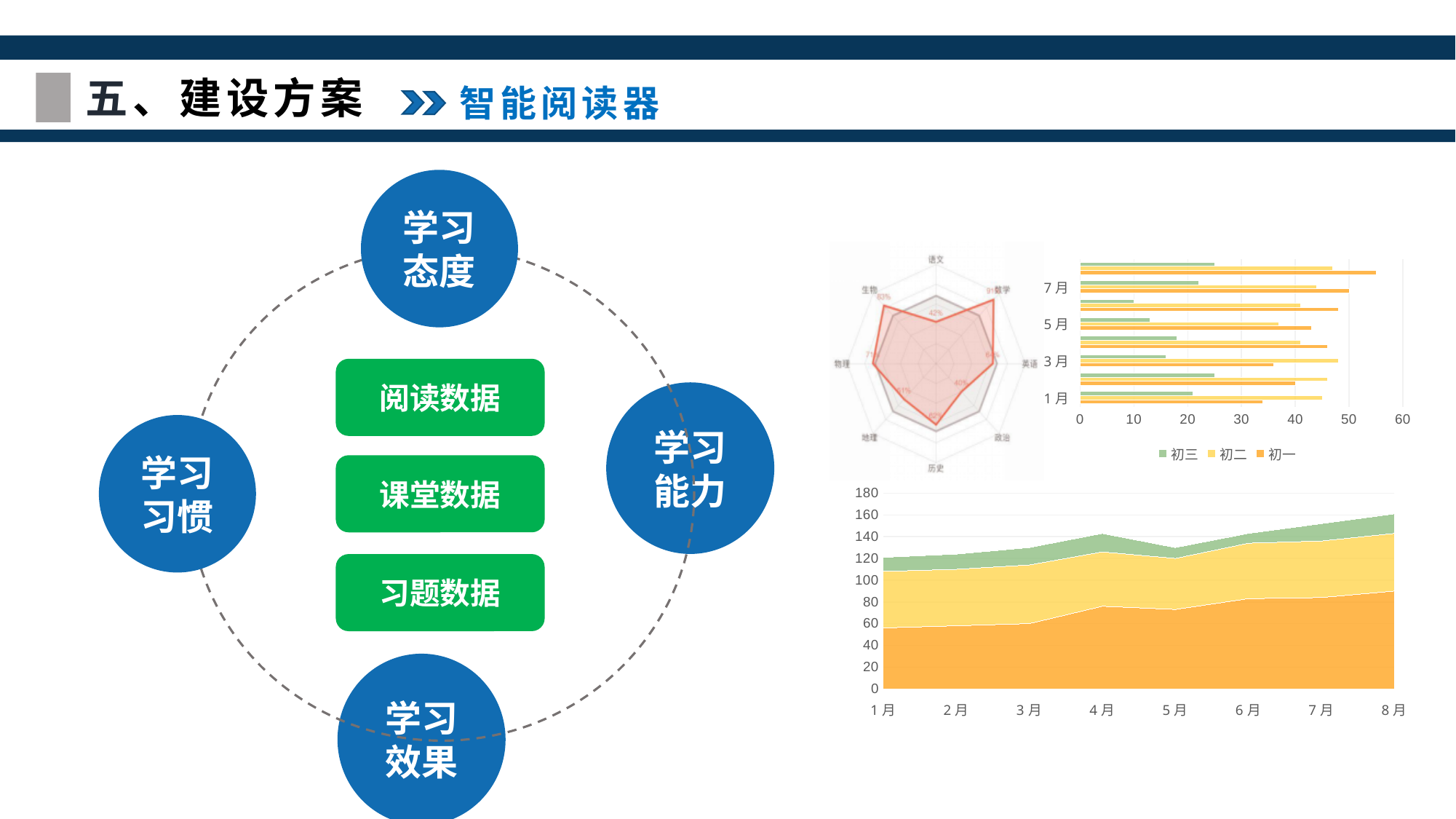
In the top-right bar chart, which series has the longest bar for 7月, 初三 or 初一? 初一 In the bottom-right area chart, does the stacked total generally rise or fall from 1月 to 8月? rise In the top-right bar chart, is the 初三 value for 1月 greater or less than 30? less In the bottom-right area chart, is the top of the stacked area at 8月 greater or less than 140? greater What kind of chart is the small chart with subject labels such as 语文 and 数学 in the middle of the slide? radar chart What kind of chart is the chart at the top right of the slide with the 初三/初二/初一 legend? bar chart What kind of chart is the chart at the bottom right of the slide? area chart How many series does the legend of the top-right bar chart list? 3 In the bottom-right area chart, is the top of the stacked area at 1月 greater or less than 140? less What are the legend entries of the top-right bar chart? 初三, 初二, 初一 How many months are shown on the x axis of the bottom-right area chart? 8